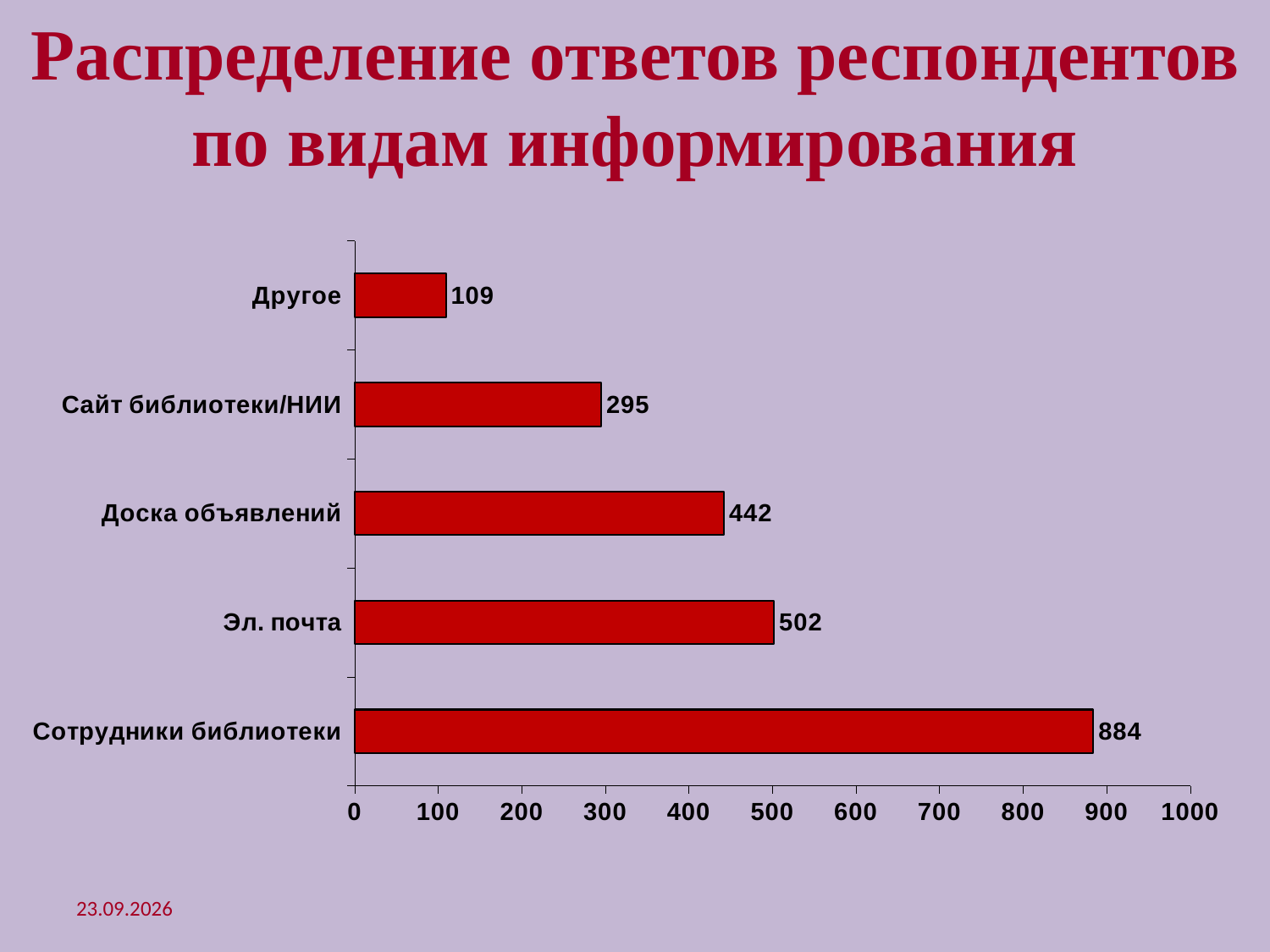
What is the difference between the values for Сотрудники библиотеки and Эл. почта? 382 What is the value for Доска объявлений? 442 What is the value for Сотрудники библиотеки? 884 Which is larger, the value for Доска объявлений or the value for Сайт библиотеки/НИИ? Доска объявлений What is the title of the slide? Распределение ответов респондентов по видам информирования What kind of chart is shown on the slide? Bar chart What is the value for Сайт библиотеки/НИИ? 295 What is the value for Эл. почта? 502 What is the value for Другое? 109 Which category has the highest value? Сотрудники библиотеки Which category has the lowest value? Другое How many categories are shown in the chart? 5